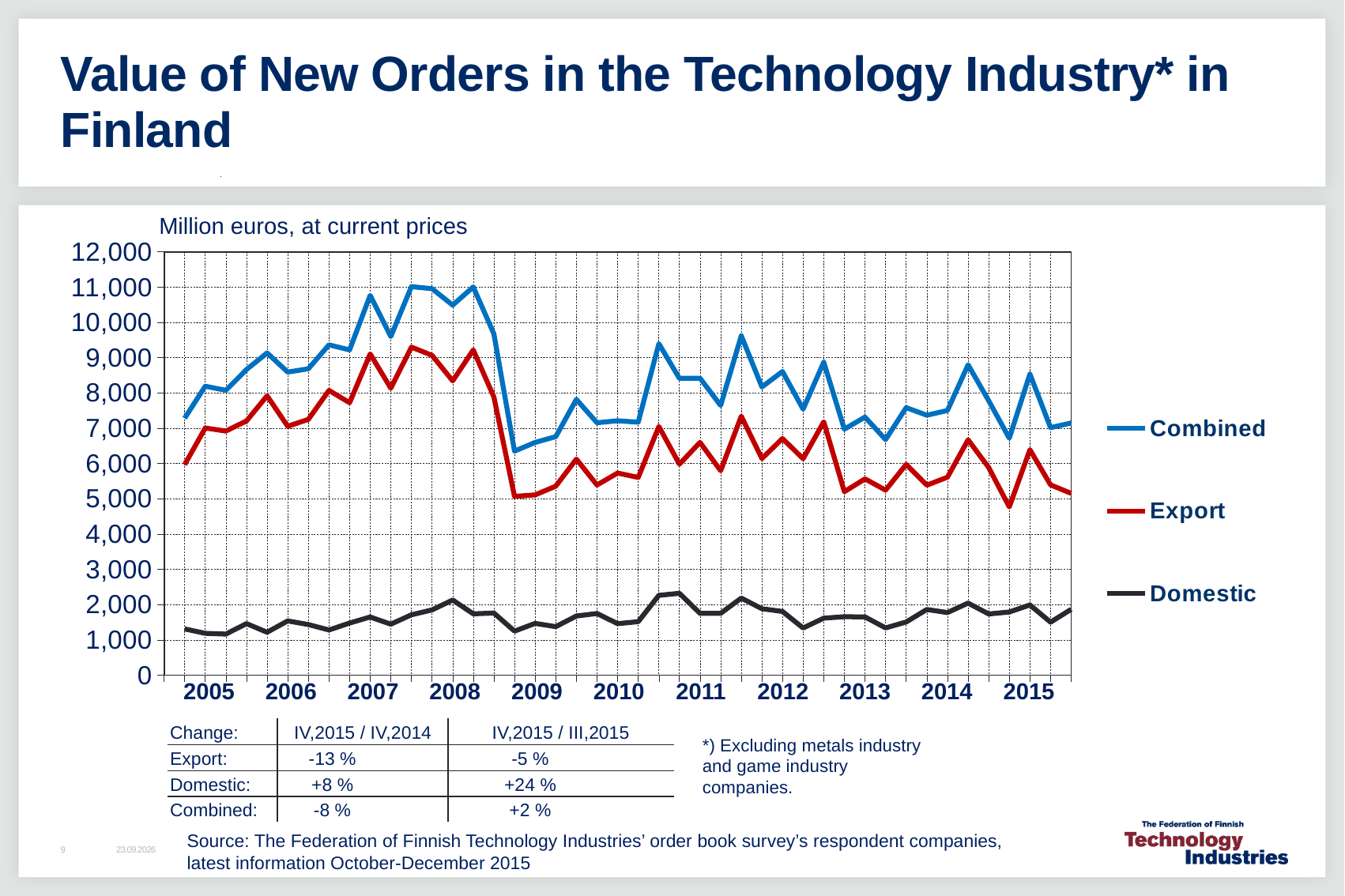
Is the peak value of the Combined series in 2007–2008 greater or less than 10,000? greater Which series has the highest values throughout the chart? Combined How many series does the legend list? 3 Is the lowest value of the Export series in 2009 greater or less than 6,000? less Which series has the lowest values throughout the chart? Domestic How many years are labelled on the x axis? 11 Is the highest value of the Domestic series greater or less than 3,000? less Does the Combined series rise or fall between 2008 and 2009? fall What unit is stated above the chart's y axis? Million euros, at current prices What kind of chart is shown on the slide? line chart Which is larger in 2012, the Export series or the Domestic series? Export Which series is plotted in red? Export